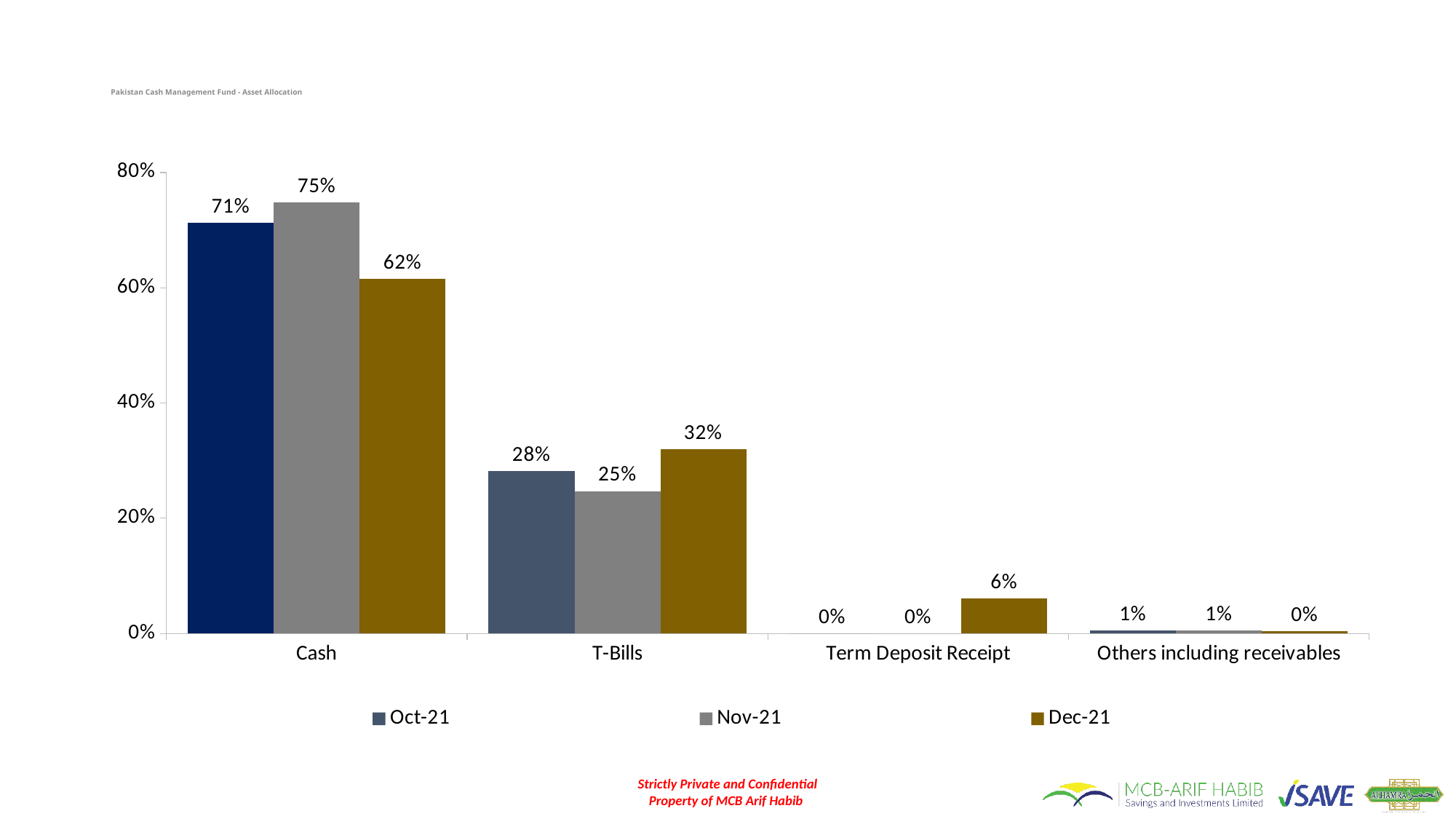
What is the T-Bills allocation for Dec-21? 32% What kind of chart is shown on the slide? Bar chart How many categories are shown on the x axis? 4 What is the Cash allocation for Nov-21? 75% What is the Others including receivables allocation for Oct-21? 1% What is the Term Deposit Receipt allocation for Dec-21? 6% What is the difference between the Cash allocation in Nov-21 and Dec-21? 13% Which month has the lowest Cash allocation? Dec-21 How many series does the legend list? 3 What is the title of the chart? Pakistan Cash Management Fund - Asset Allocation Which category has the highest allocation for Oct-21? Cash Which is larger, the T-Bills allocation for Oct-21 or for Nov-21? Oct-21